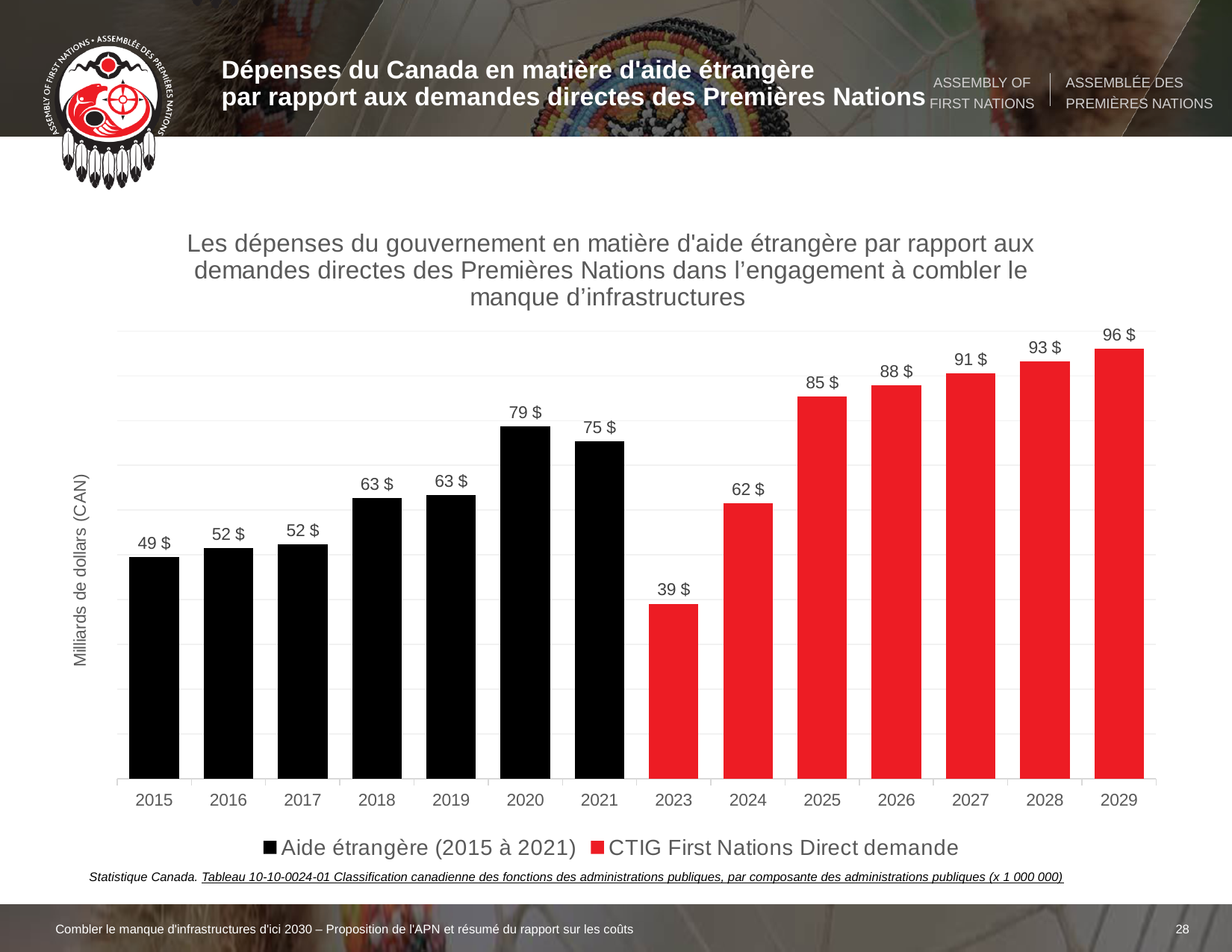
Which year has the highest value in the chart? 2029 What is the difference between the values for 2020 and 2015? 30 $ What is the value for 2029 in the chart? 96 $ What is the value for 2023 in the chart? 39 $ How many years are shown on the x axis of the chart? 14 How many series does the legend list? 2 What kind of chart is shown on the slide? Bar chart Do the values for the CTIG First Nations Direct demande series rise or fall from 2023 to 2029? Rise What is the difference between the values for 2029 and 2021? 21 $ Which is larger, the value for 2021 or the value for 2024? 2021 Which year has the lowest value in the chart? 2023 What is the value for 2020 in the chart? 79 $